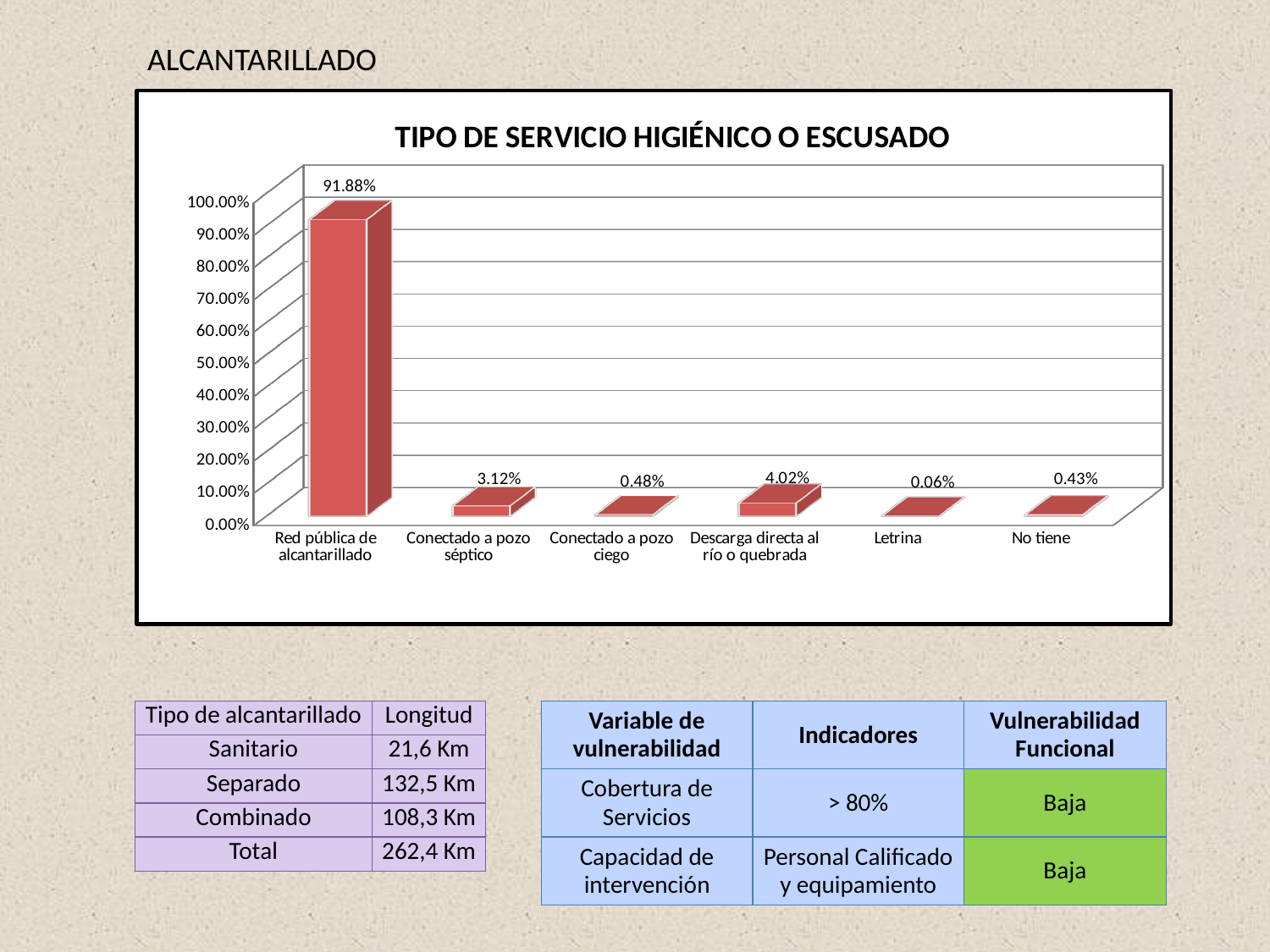
What is the difference between Descarga directa al río o quebrada and Conectado a pozo séptico? 0.90% Is the value for Red pública de alcantarillado greater or less than 90.00%? greater What is the value for Letrina? 0.06% What kind of chart is shown? bar chart What is the value for Conectado a pozo séptico? 3.12% What is the value for Red pública de alcantarillado? 91.88% Which category has the highest value? Red pública de alcantarillado What is the title of the chart? TIPO DE SERVICIO HIGIÉNICO O ESCUSADO How many categories are shown on the x axis? 6 What is the value for Descarga directa al río o quebrada? 4.02% Which is larger, Conectado a pozo ciego or No tiene? Conectado a pozo ciego Which category has the lowest value? Letrina